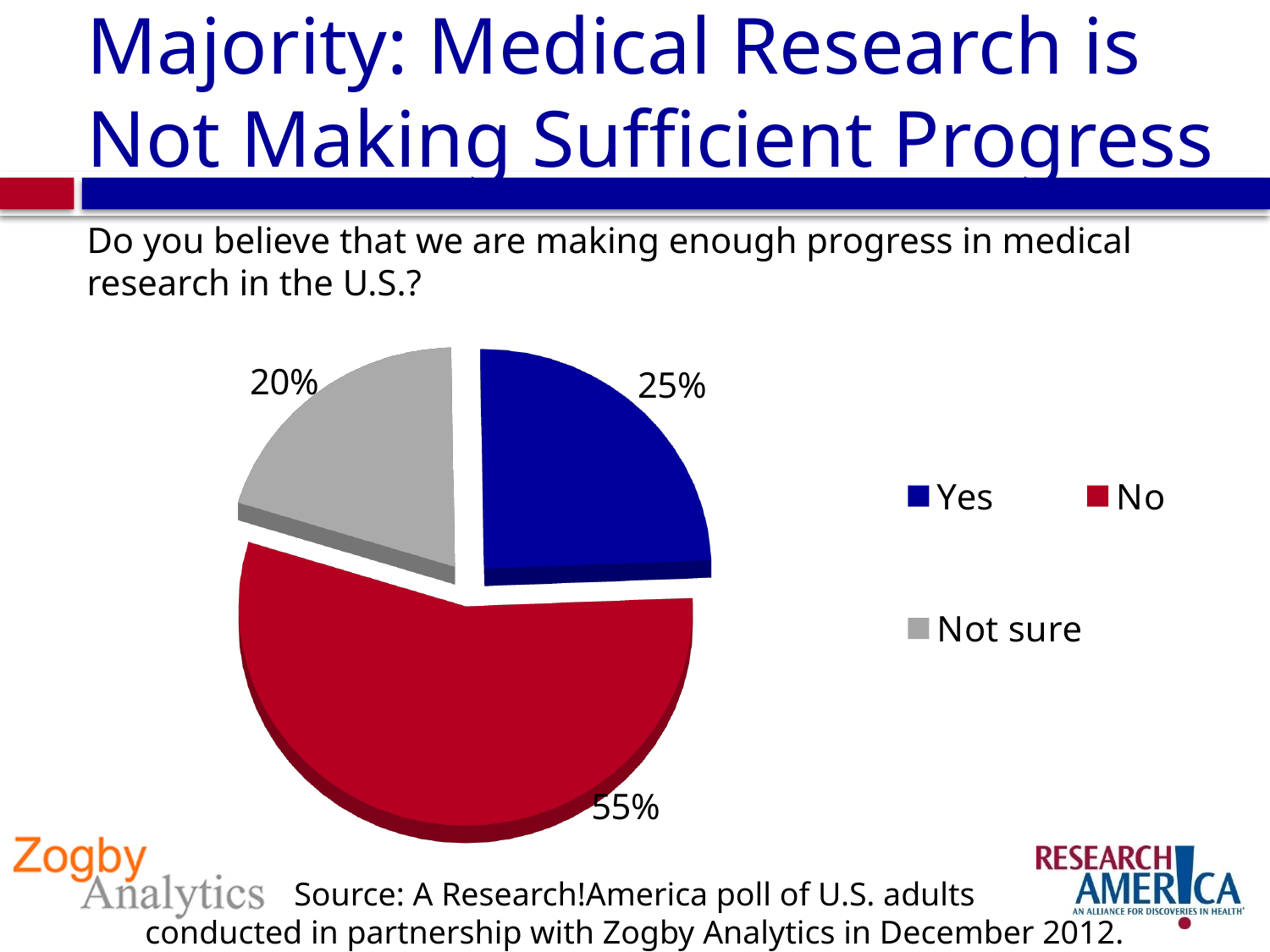
What percentage of respondents answered "Yes"? 25% Is the share for "No" greater or less than 50%? greater How many response categories are shown in the pie chart? 3 What is the difference in percentage points between the "No" and "Yes" responses? 30 Which response has the smallest share of the pie? Not sure What colour represents the "No" response in the pie chart? Red What survey question does the chart present? Do you believe that we are making enough progress in medical research in the U.S.? Which response has the largest share of the pie? No What percentage of respondents answered "Not sure"? 20% Which is larger, the share for "Yes" or the share for "Not sure"? Yes What kind of chart is shown on the slide? Pie chart What percentage of respondents answered "No"? 55%